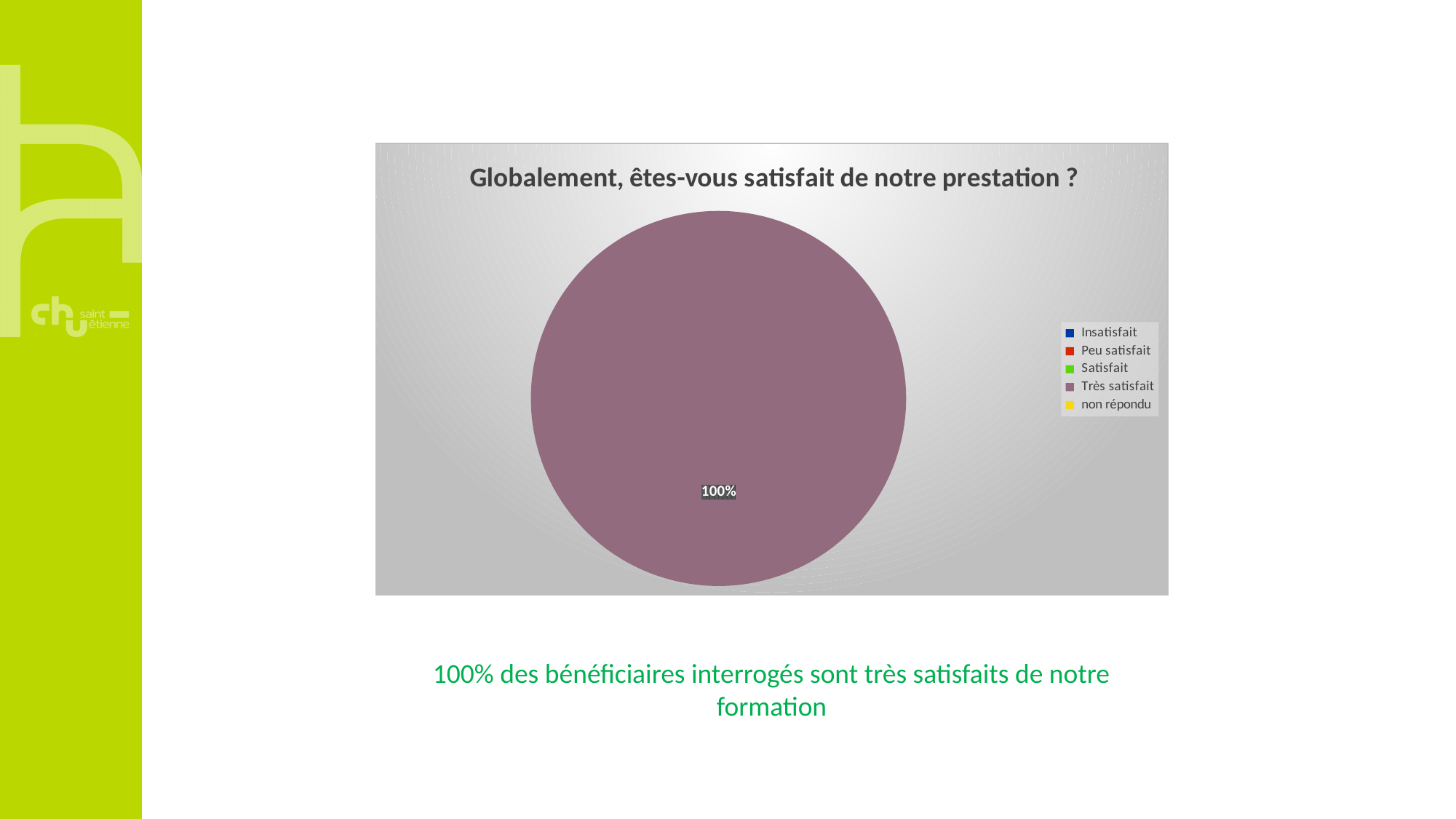
Which legend entry is shown in purple? Très satisfait What is the title of the chart? Globalement, êtes-vous satisfait de notre prestation ? How many entries does the chart's legend list? 5 What kind of chart is shown on the slide? pie chart Which is larger, the share for "Très satisfait" or the share for "Satisfait"? Très satisfait What share of the pie does "Très satisfait" take? 100% How many visible slices does the pie have? 1 What is the data label printed on the pie slice? 100% Which category has the largest share of the pie? Très satisfait